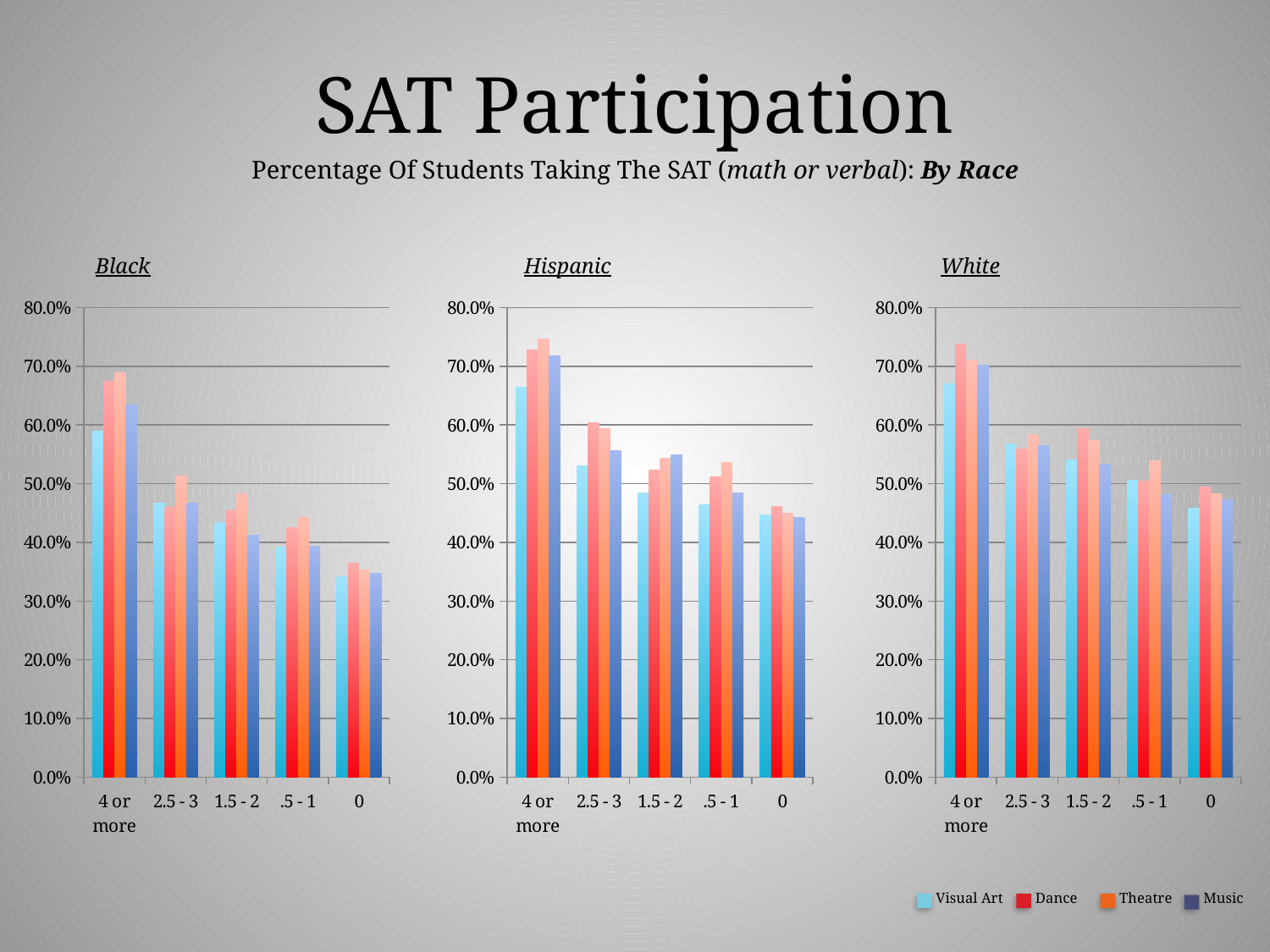
What kind of chart is the Black chart? bar chart In the Hispanic chart, which category has the highest Theatre value? 4 or more In the Hispanic chart, which is larger: Visual Art at "4 or more" or Visual Art at "2.5 - 3"? 4 or more In the Black chart, is the value for Visual Art at "0" greater or less than 40.0%? less In the White chart, which category has the lowest Visual Art value? 0 In the Black chart, is the value for Theatre at "4 or more" greater or less than 60.0%? greater How many categories are shown on the x axis of the Hispanic chart? 5 In the White chart, is the value for Visual Art at "0" greater or less than 50.0%? less What are the four series named in the legend? Visual Art, Dance, Theatre, Music In the Black chart, do the Visual Art values generally rise or fall from "4 or more" to "0"? fall How many series does the legend list? 4